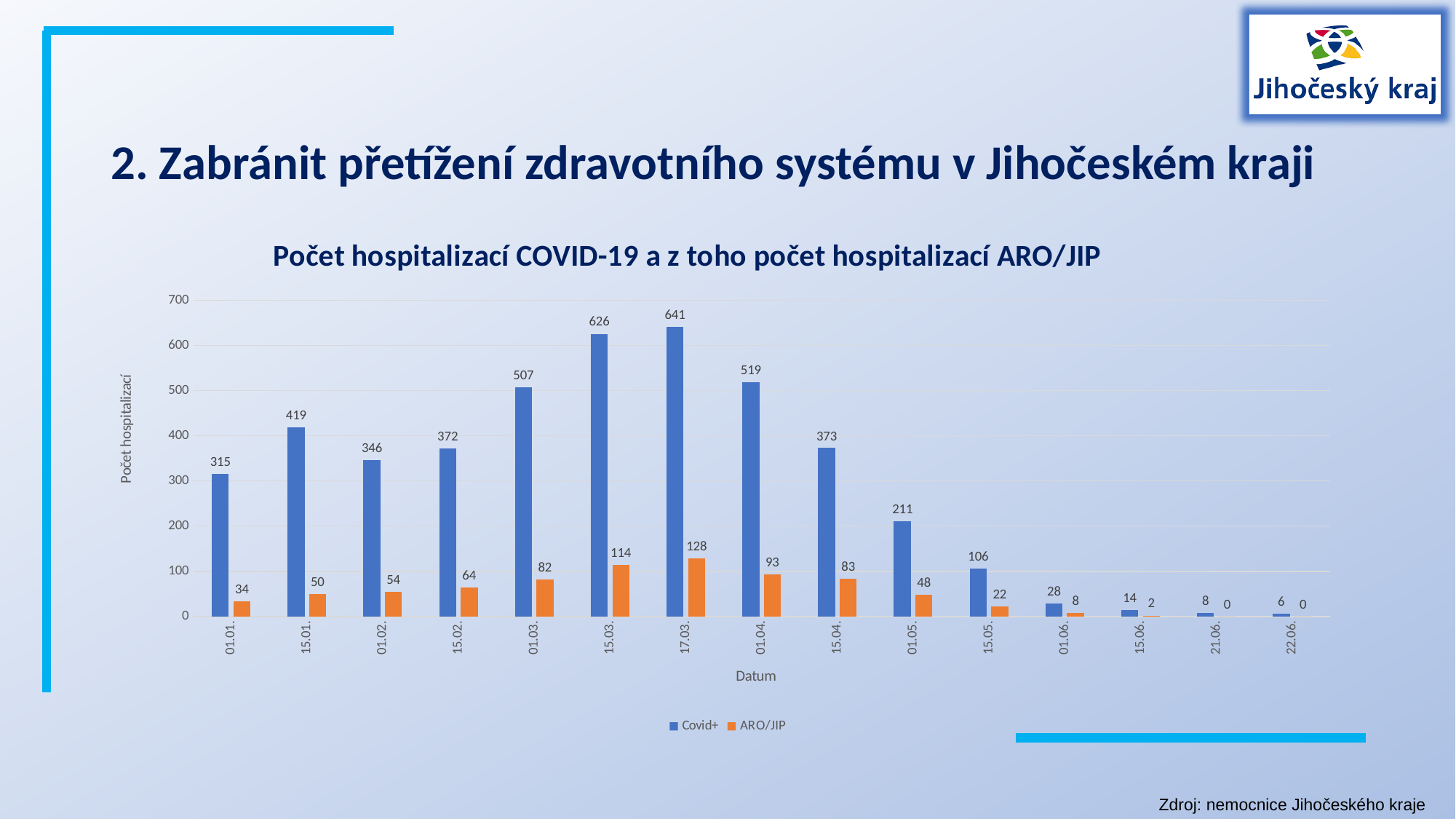
What is the Covid+ value for 17.03.? 641 What is the difference between the Covid+ values for 15.03. and 01.04.? 107 What is the Covid+ value for 01.01.? 315 What is the ARO/JIP value for 01.04.? 93 On which date is the Covid+ value highest? 17.03. Which colour represents the ARO/JIP series? Orange On which date is the Covid+ value lowest? 22.06. How many series does the legend list? 2 On which date is the ARO/JIP value highest? 17.03. How many dates are shown on the x axis? 15 What kind of chart is shown? Bar chart Which is larger, the Covid+ value for 15.01. or for 15.04.? 15.01.